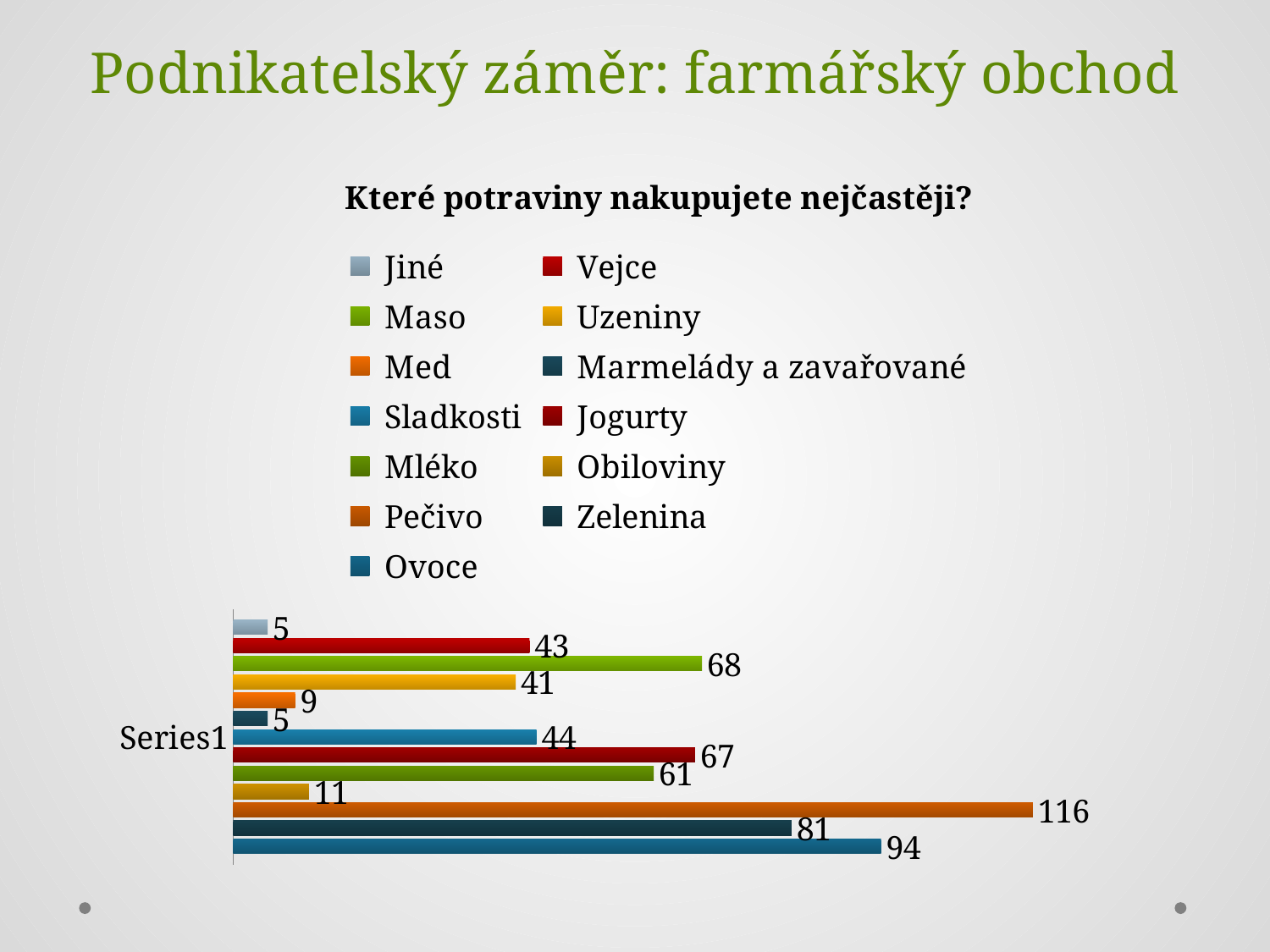
What is the value for Med? 9 What is the value for Pečivo? 116 Which series has the highest value? Pečivo What is the value for Uzeniny? 41 What is the value for Zelenina? 81 What is the value for Ovoce? 94 What kind of chart is shown on the slide? Bar chart What is the difference between the values for Maso and Vejce? 25 What is the title of the chart? Které potraviny nakupujete nejčastěji? How many series does the legend list? 13 What is the difference between the values for Pečivo and Ovoce? 22 Which is larger, the value for Jogurty or the value for Mléko? Jogurty